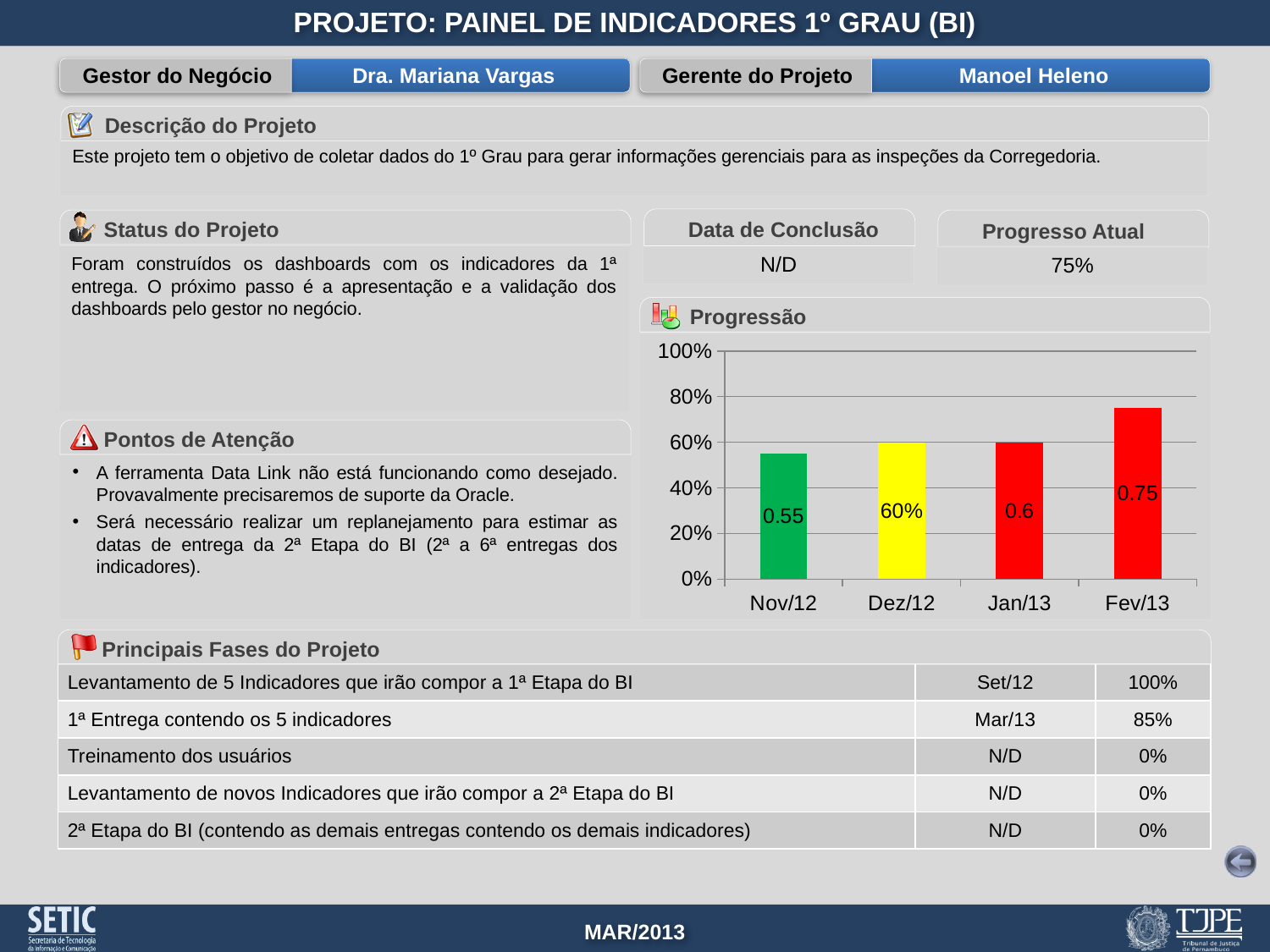
What is the value shown for Jan/13 in the Progressão chart? 0.6 Which month has the highest bar in the Progressão chart? Fev/13 How many months are plotted in the Progressão chart? 4 Which month has the lowest bar in the Progressão chart? Nov/12 What is the value shown for Dez/12 in the Progressão chart? 60% In the Progressão chart, what is the difference between the values for Fev/13 and Nov/12? 0.2 In the Progressão chart, is the value for Nov/12 greater or less than 40%? greater What kind of chart is the Progressão chart? bar chart What is the value shown for Nov/12 in the Progressão chart? 0.55 In the Progressão chart, which is larger: the value for Fev/13 or the value for Nov/12? Fev/13 What is the value shown for Fev/13 in the Progressão chart? 0.75 Do the values in the Progressão chart rise or fall from Nov/12 to Fev/13? rise